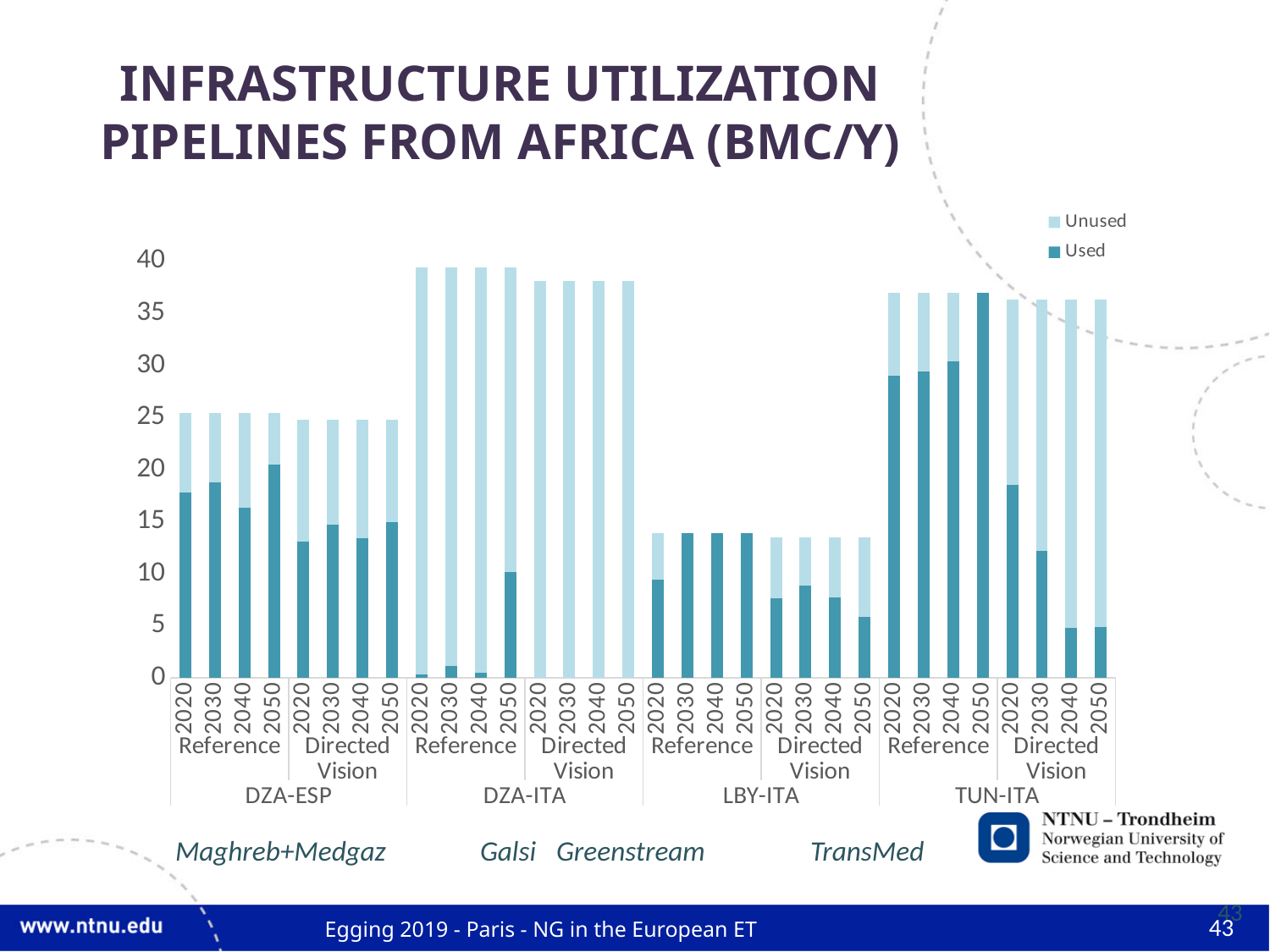
What kind of chart is shown on the slide? Stacked bar chart Is the total bar height for LBY-ITA Reference 2020 greater or less than 15? less Does the Used value for TUN-ITA Directed Vision rise or fall from 2020 to 2050? fall Which pipeline group has the tallest total bars? DZA-ITA Is the Used value for DZA-ITA Reference 2020 greater or less than 5? less Which is larger, the Used value for TUN-ITA Reference 2020 or the Used value for DZA-ESP Reference 2020? TUN-ITA Reference 2020 How many pipeline groups (e.g. DZA-ESP) are shown along the x axis? 4 What is the title of the chart on the slide? INFRASTRUCTURE UTILIZATION PIPELINES FROM AFRICA (BMC/Y) Is the total bar height for DZA-ITA Reference 2020 greater or less than 35? greater How many bars are plotted in total on the chart? 32 What are the two series named in the legend? Unused and Used How many series does the legend list? 2